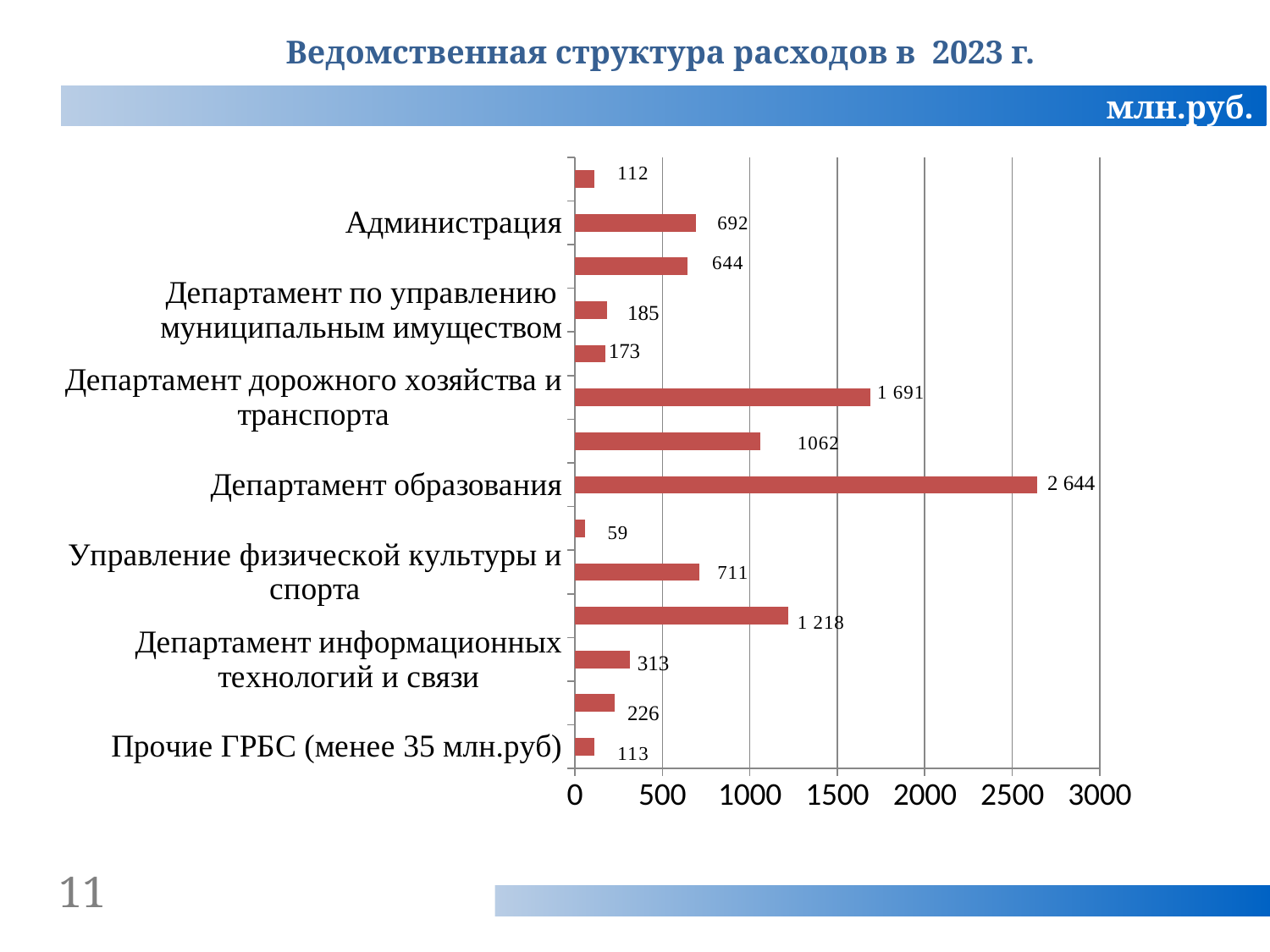
Which category has the highest value? Департамент образования What kind of chart is shown on the slide? bar chart How many bars are plotted on the chart? 14 What is the value for Администрация? 692 What is the value for Прочие ГРБС (менее 35 млн.руб)? 113 What is the smallest value shown on the chart? 59 What is the value for Департамент дорожного хозяйства и транспорта? 1 691 Which is larger, the value for Управление физической культуры и спорта or the value for Администрация? Управление физической культуры и спорта What is the difference between the values for Департамент образования and Департамент дорожного хозяйства и транспорта? 953 Is the value for Департамент образования greater or less than 2500? greater What is the value for Департамент информационных технологий и связи? 313 What is the value for Департамент образования? 2 644